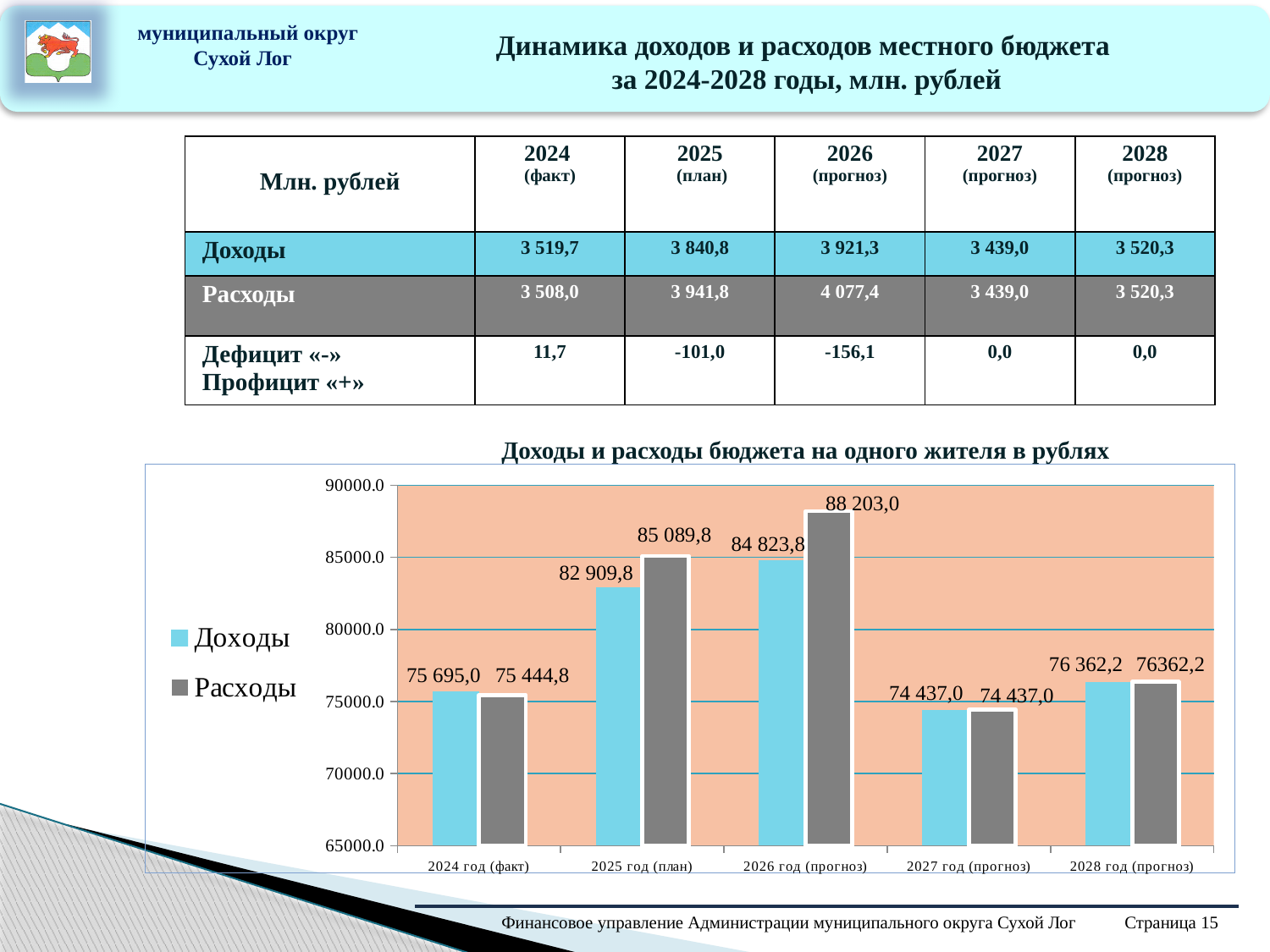
How many year categories are shown on the x axis of the chart? 5 Do the Доходы values rise or fall from 2024 год (факт) to 2026 год (прогноз)? rise Is the value of Расходы for 2027 год (прогноз) greater or less than 75000? less In which year is Доходы lowest in the chart? 2027 год (прогноз) What kind of chart is shown on the slide? bar chart What is the value of Расходы for 2025 год (план) in the chart? 85 089,8 What is the value of Доходы for 2026 год (прогноз) in the chart 'Доходы и расходы бюджета на одного жителя в рублях'? 84 823,8 What is the difference between Расходы and Доходы for 2026 год (прогноз)? 3 379,2 What is the value of Доходы for 2024 год (факт) in the chart? 75 695,0 Which is larger for 2025 год (план): Доходы or Расходы? Расходы How many series does the chart legend list? 2 In which year is Расходы highest in the chart? 2026 год (прогноз)